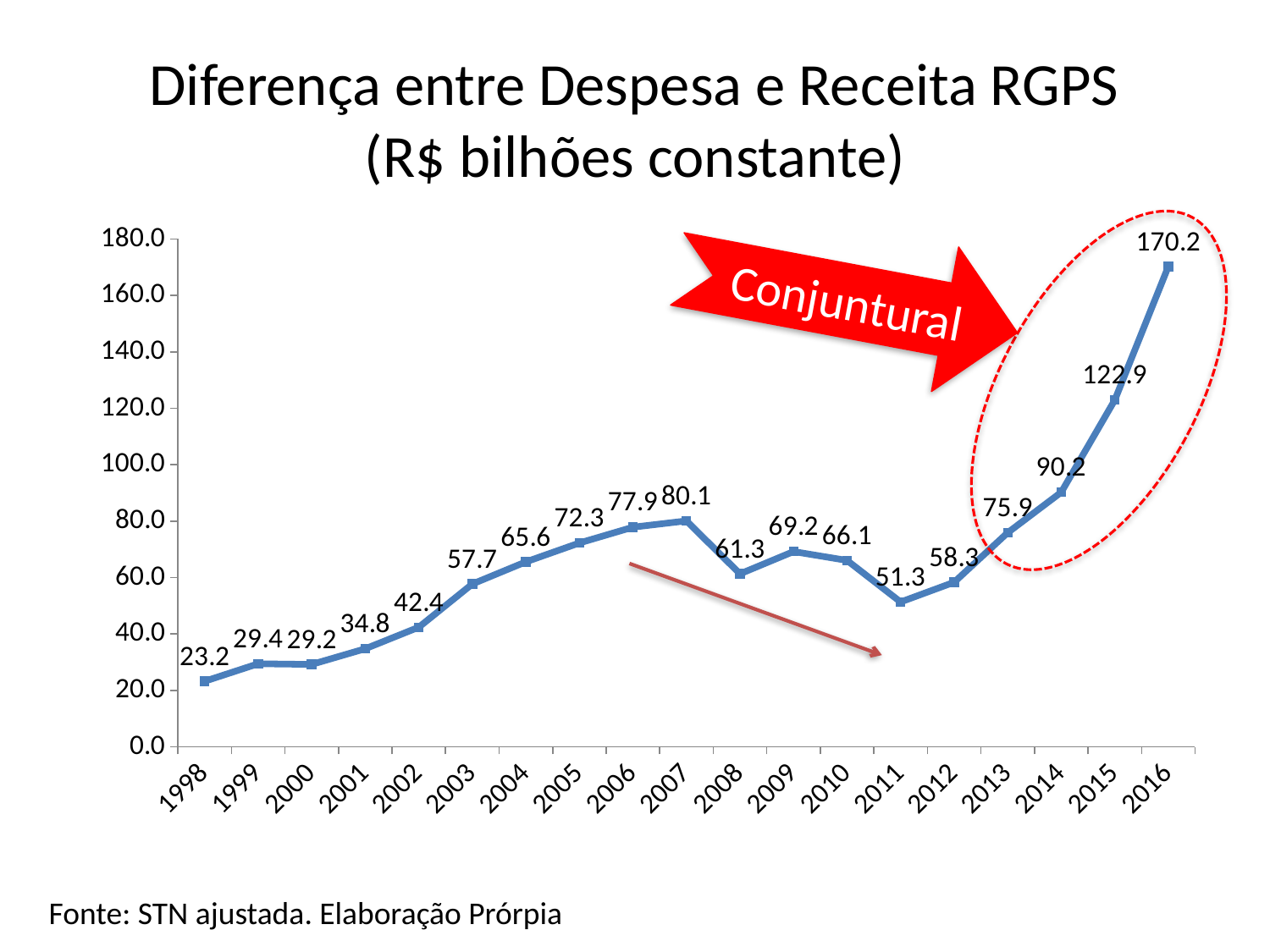
What is the value for 2016? 170.2 Is the value for 2014 greater or less than 100.0? less Which year has the highest value? 2016 What is the value for 2011? 51.3 What kind of chart is shown on the slide? line chart What is the value for 2007? 80.1 How many years are plotted on the x axis? 19 Which year has the lowest value? 1998 What is the value for 1998? 23.2 What is the difference between the values for 2016 and 2015? 47.3 What is the title of the chart? Diferença entre Despesa e Receita RGPS (R$ bilhões constante) Which is larger, the value for 2009 or the value for 2010? 2009